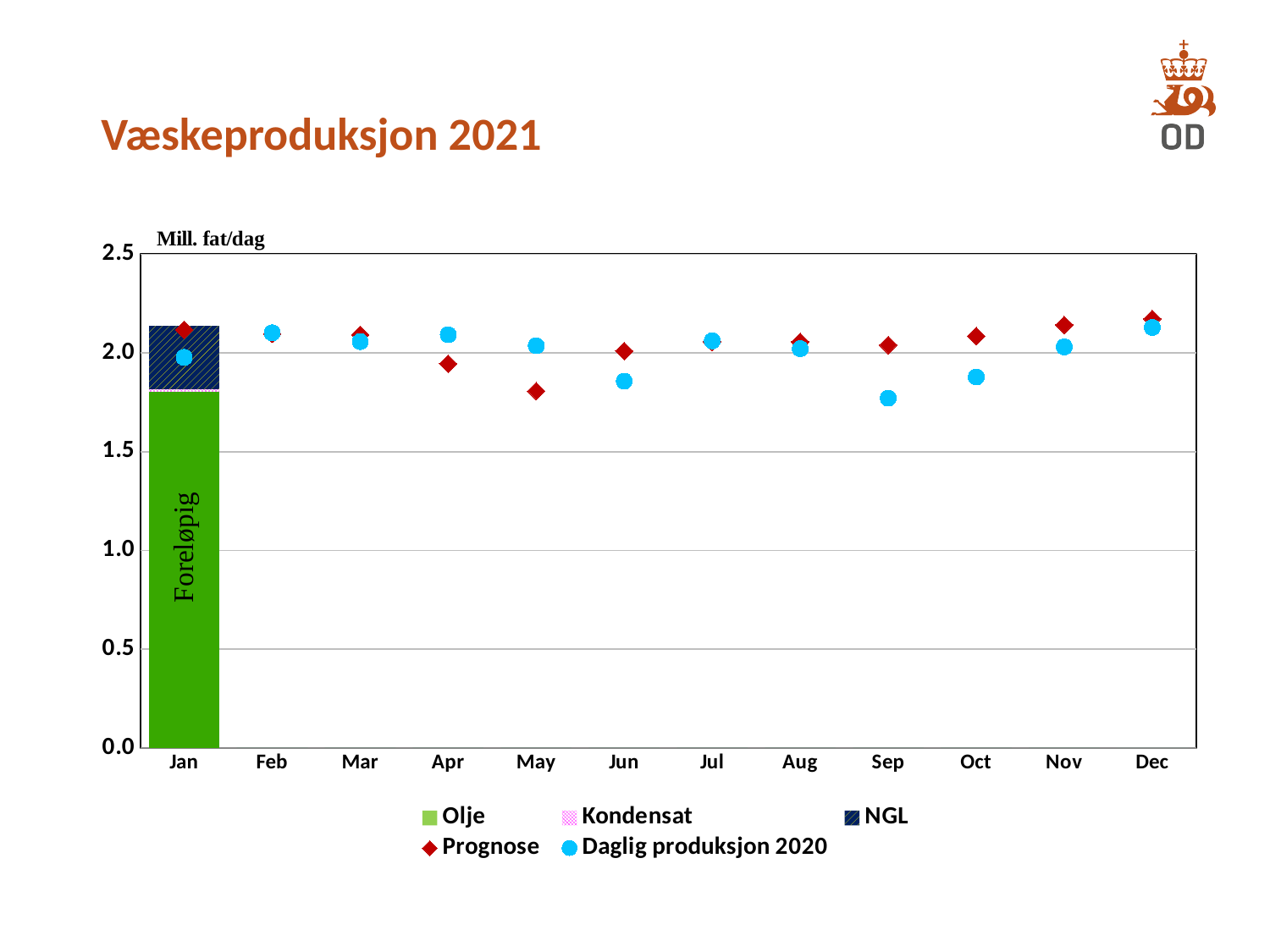
How many months are shown on the x axis? 12 Is the total of the stacked bar for Jan greater or less than 2.0? greater How many series does the legend list? 5 In which month is Daglig produksjon 2020 lowest? Sep What is the title of the chart? Væskeproduksjon 2021 In Jun, which is larger: Prognose or Daglig produksjon 2020? Prognose Is the value for Daglig produksjon 2020 in Sep greater or less than 2.0? less Is the value for Prognose in May greater or less than 2.0? less In which month is Prognose lowest? May What unit is shown above the y axis? Mill. fat/dag What kind of chart is shown on the slide? A bar chart combined with scatter points